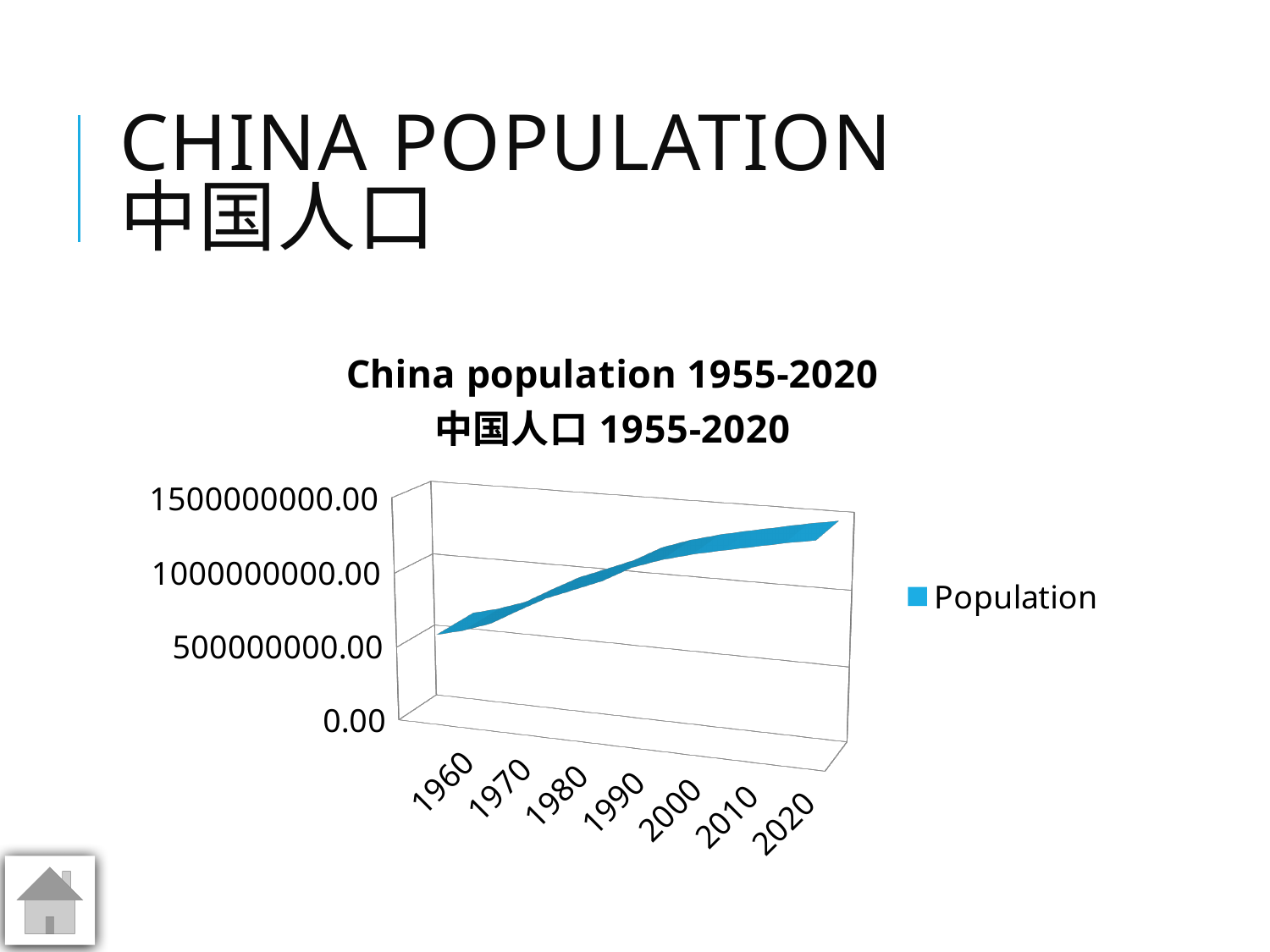
Is the population value for 2020 greater or less than 1000000000.00? greater Is the population value for 2020 larger than the value for 1960? Yes What is the name of the series shown in the legend? Population How many years are labelled on the x axis? 7 Is the population value for 1960 greater or less than 1000000000.00? less Is the population value for 2020 greater or less than 1500000000.00? less Do the population values rise or fall from 1960 to 2020? Rise Which year has the highest population value? 2020 What kind of chart is shown on the slide? Line chart How many series does the legend list? 1 What is the title of the chart? China population 1955-2020 中国人口 1955-2020